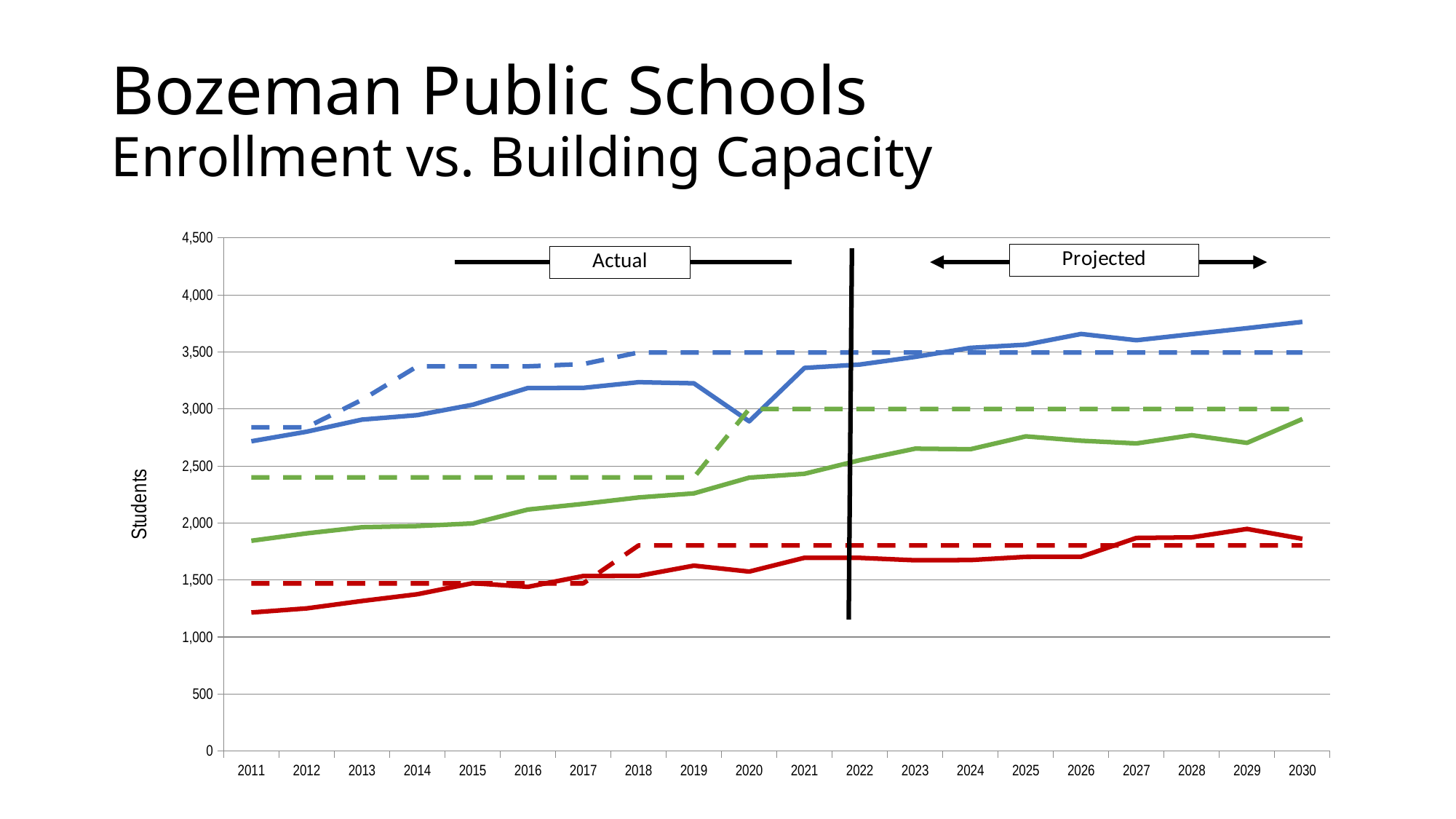
What kind of chart is shown on the slide? Line chart How many years are shown along the x axis of the chart? 20 Is the value of the solid blue line in 2030 greater or less than 3,500? greater What is the label on the vertical axis of the chart? Students What value does the dashed green line hold from 2020 through 2030? 3,000 In which year does the solid red line reach its lowest value? 2011 What are the two labels that divide the chart into time periods? Actual and Projected Does the solid blue line generally rise or fall from 2011 to 2030? rise Is the value of the solid red line in 2011 greater or less than 1,500? less Is the value of the solid green line in 2011 greater or less than 2,000? less In 2030, which is higher: the solid blue line or the solid green line? Solid blue line